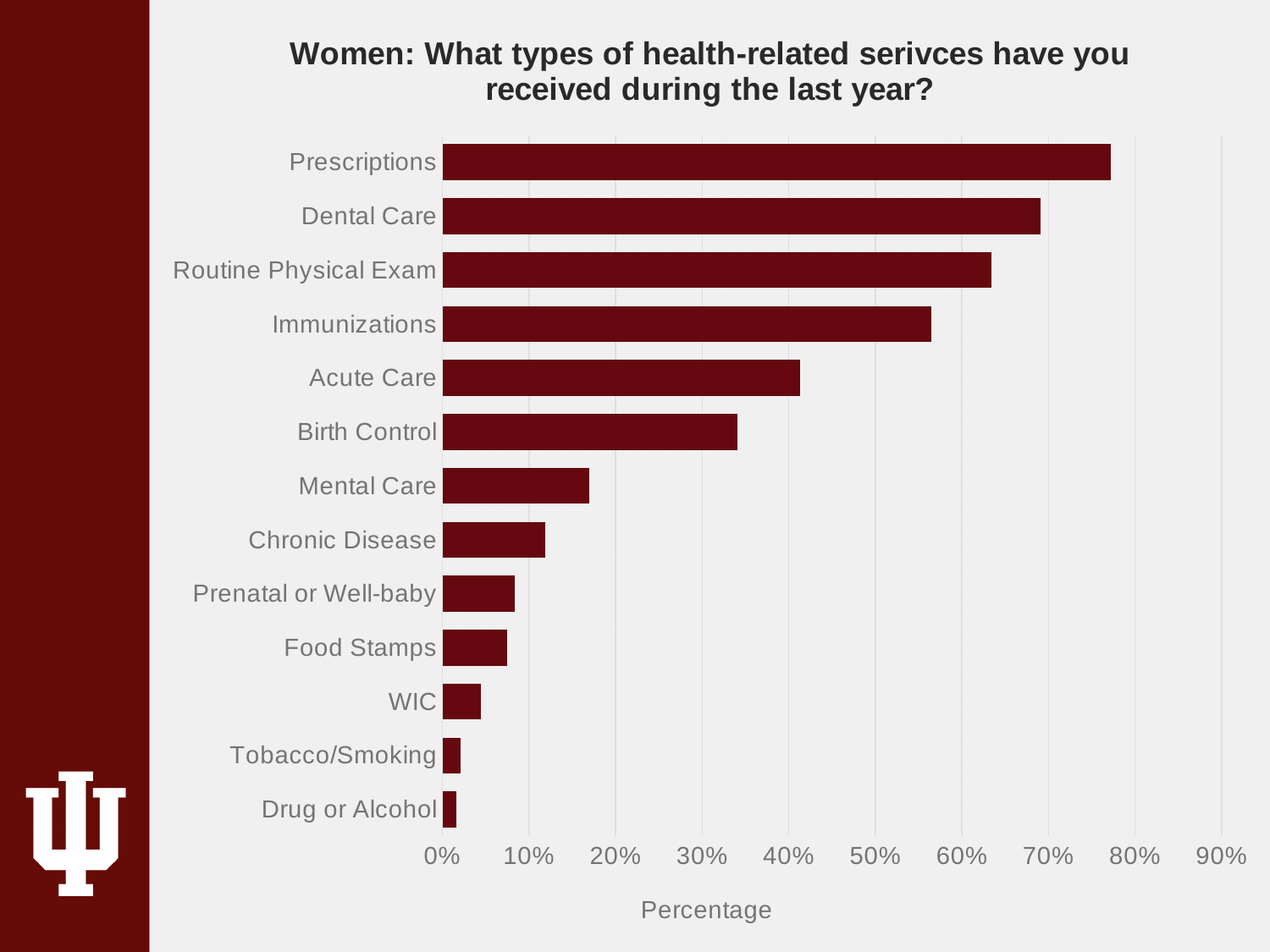
Is the value for Dental Care greater or less than 60%? greater What type of chart is shown on the slide? bar chart Is the value for Prescriptions greater or less than 70%? greater How many categories of health-related services are shown in the chart? 13 Which is larger, the value for Routine Physical Exam or the value for Immunizations? Routine Physical Exam Which health-related service has the highest percentage? Prescriptions Which is larger, the value for Chronic Disease or the value for WIC? Chronic Disease What is the label of the horizontal axis? Percentage Is the value for Immunizations greater or less than 60%? less